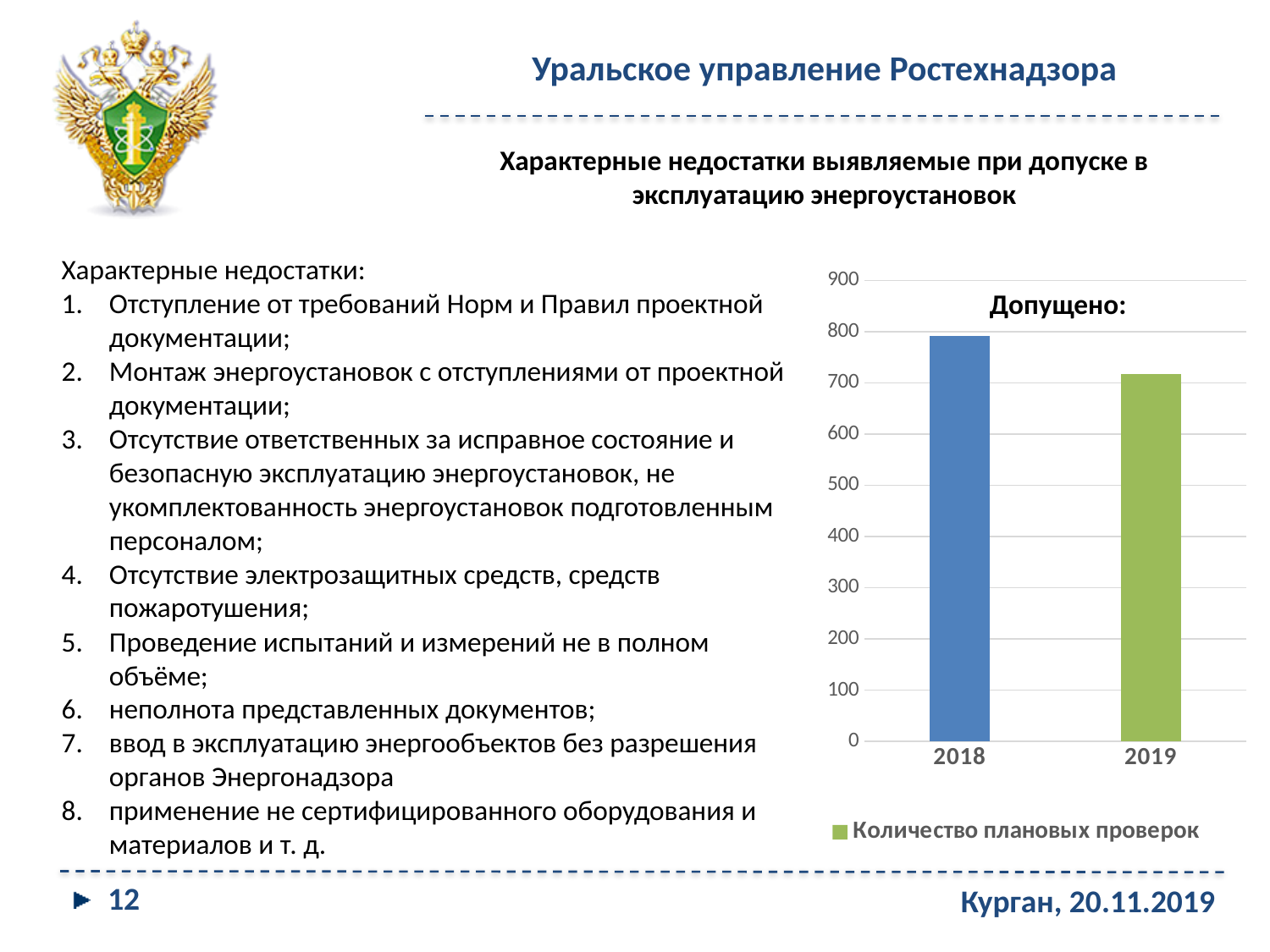
Is the value for 2019 greater or less than 800? less Is the value for 2018 greater or less than 700? greater Do the values rise or fall from 2018 to 2019? fall Which year has the lowest bar in the chart? 2019 What kind of chart is shown on the slide? bar chart Which year has the highest bar in the chart? 2018 How many series does the chart legend list? 1 Which is larger, the value for 2018 or the value for 2019? 2018 How many categories are shown on the x axis of the chart? 2 What is the title of the chart? Допущено: Is the value for 2019 greater or less than 600? greater What series name is shown in the chart legend? Количество плановых проверок